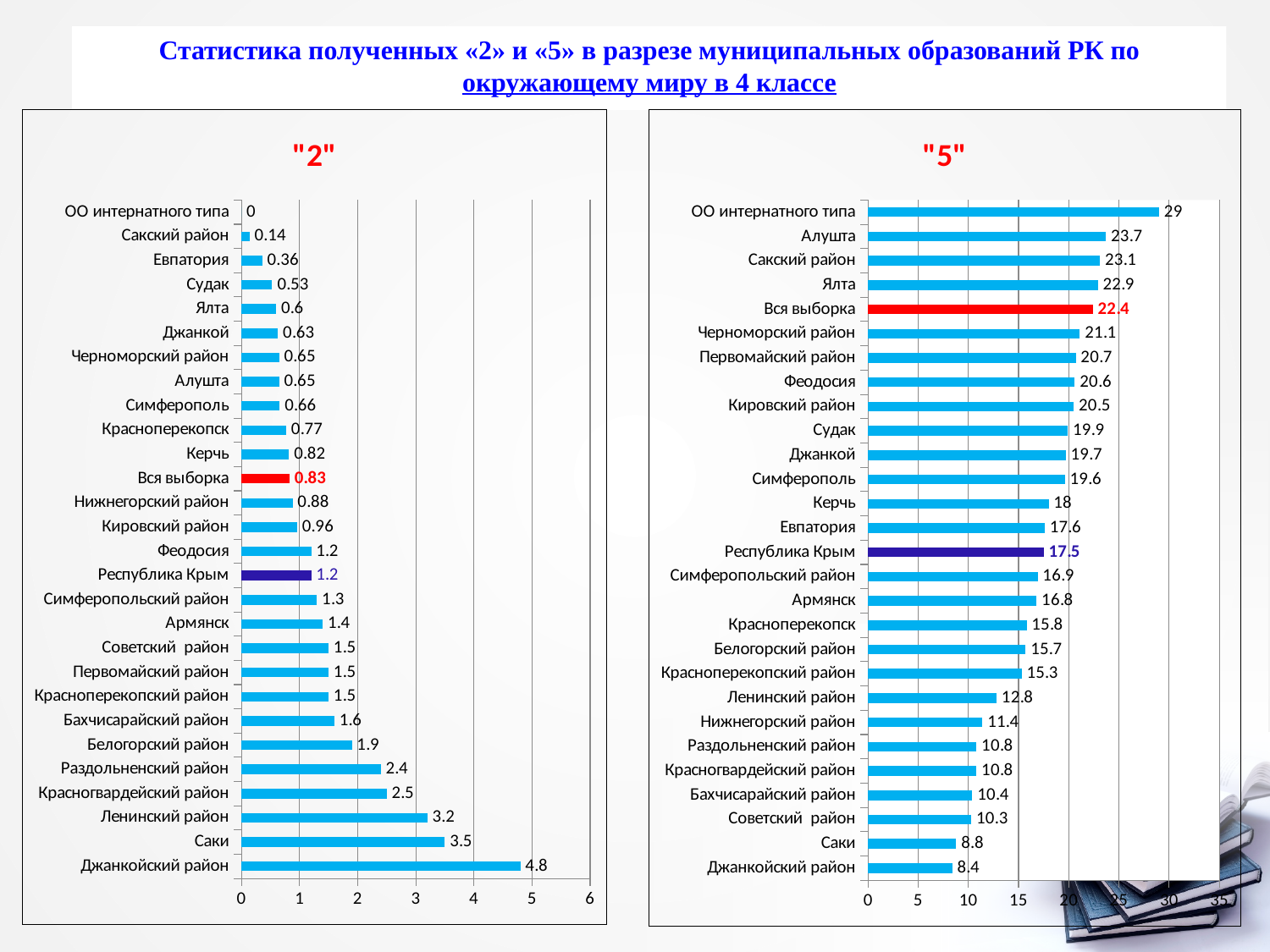
In the "5" chart, is the value for Керчь greater or less than 15? greater In the "5" chart, what is the value for Республика Крым? 17.5 In the "2" chart, which category has the lowest value? ОО интернатного типа What type of chart is the "5" chart? Bar chart How many categories are shown in the "2" chart? 28 In the "2" chart, which is larger: the value for Саки or the value for Ленинский район? Саки In the "2" chart, what is the value for Вся выборка? 0.83 In the "5" chart, what is the difference between the values for Алушта and Саки? 14.9 In the "5" chart, which category has the highest value? ОО интернатного типа In the "5" chart, which category has the lowest value? Джанкойский район In the "2" chart, what is the value for Джанкойский район? 4.8 In the "5" chart, what colour is the bar for Вся выборка? Red